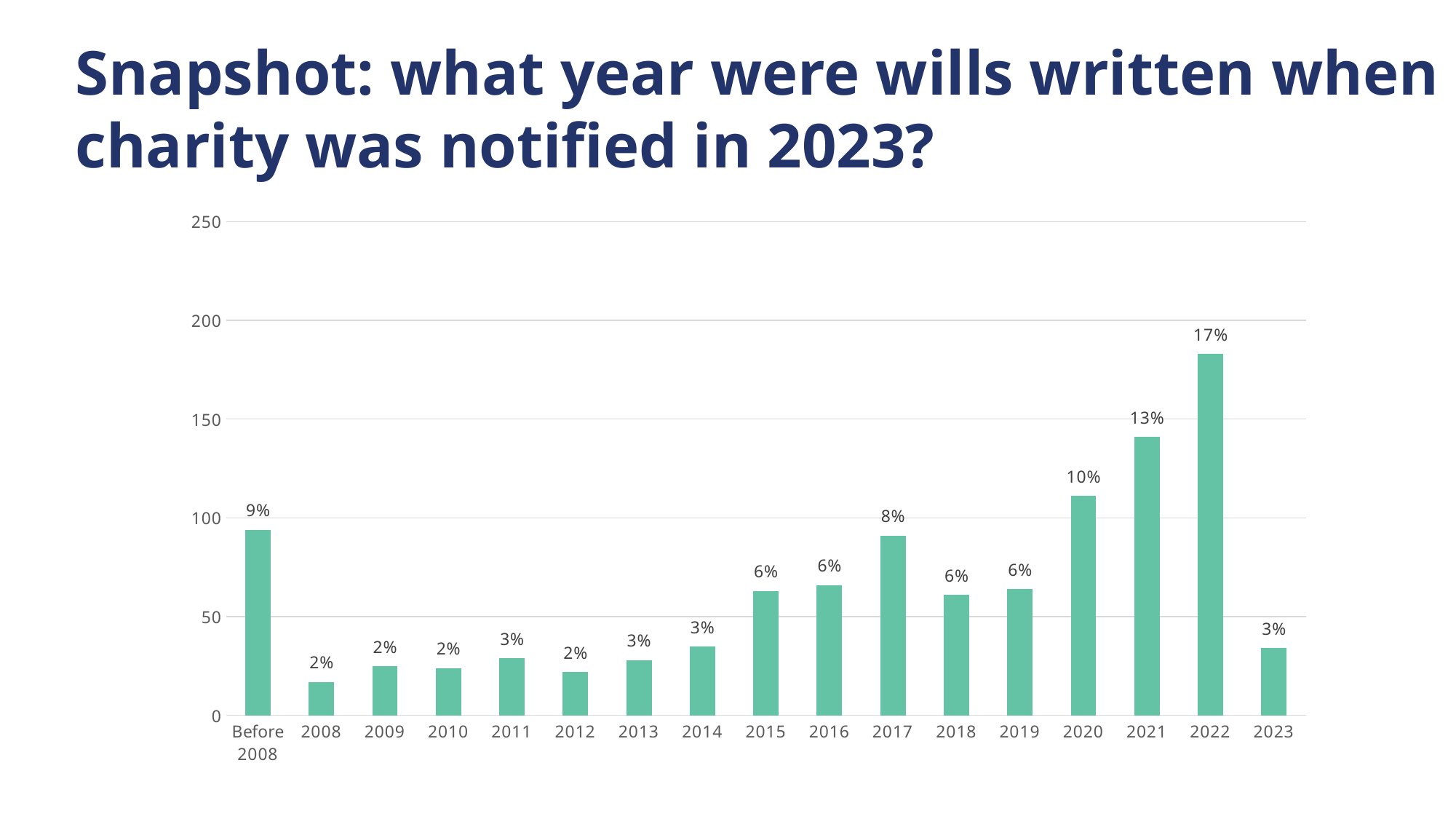
Which has the larger value, 2017 or 2019? 2017 What is the data label shown for 2022? 17% Do the values rise or fall from 2018 to 2022? Rise What kind of chart is shown on the slide? Bar chart Which year has the highest bar? 2022 What is the data label shown for Before 2008? 9% What is the data label shown for 2017? 8% Is the bar for 2020 greater or less than 100 on the axis? greater Is the bar for 2021 greater or less than 150 on the axis? less How many categories are shown on the x axis? 17 What is the difference between the labelled values for 2022 and 2021? 4% Is the bar for 2022 greater or less than 150 on the axis? greater